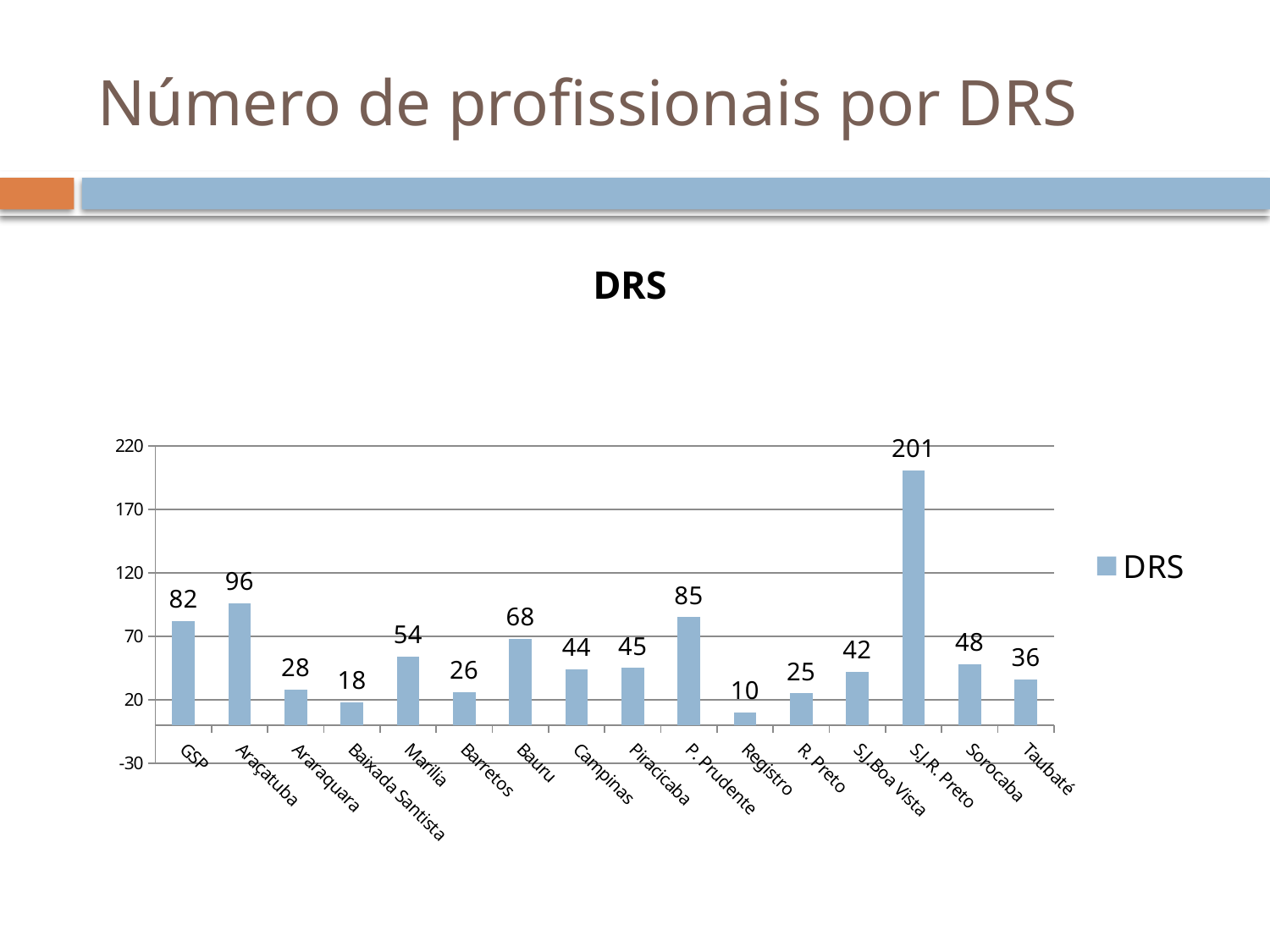
What is the value for Baixada Santista? 18 How many categories are shown on the x axis? 16 What is the value for P. Prudente? 85 What kind of chart is shown? bar chart What is the title of the chart? DRS Which category has the highest value? S.J.R. Preto Which is larger, the value for Sorocaba or the value for Taubaté? Sorocaba How many series does the legend list? 1 Is the value for S.J.R. Preto greater or less than 170? greater What is the difference between the values for Araçatuba and GSP? 14 Which category has the lowest value? Registro What is the value for Bauru? 68